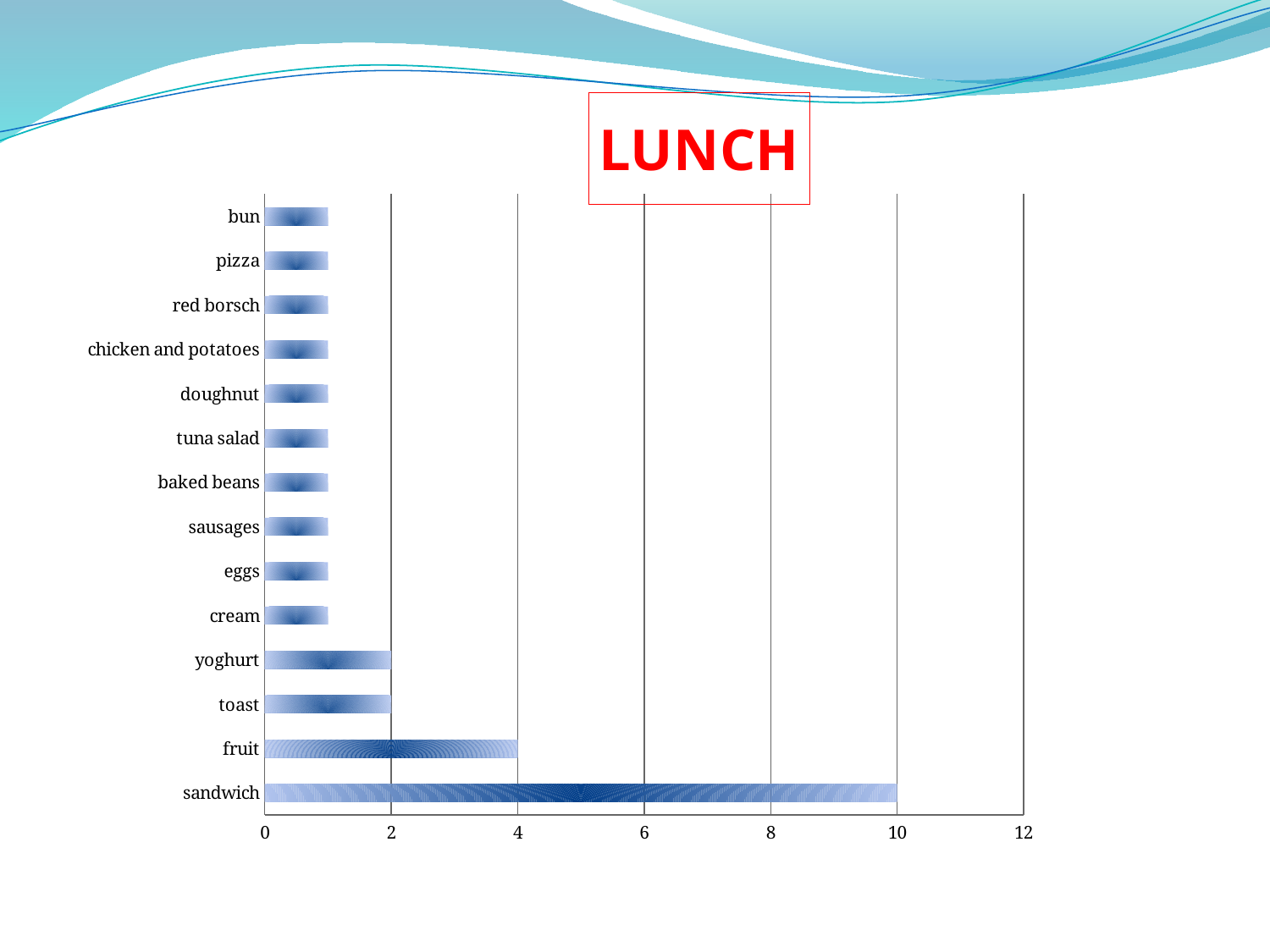
What kind of chart is shown on the slide? bar chart Is the value for bun greater or less than 2? less Which category has the highest value? sandwich What is the value for yoghurt? 2 What is the value for fruit? 4 How many categories are shown in the chart? 14 What is the value for sandwich? 10 What is the difference between the values for fruit and toast? 2 Which is larger, the value for fruit or the value for yoghurt? fruit What is the value for toast? 2 What is the title of the chart? LUNCH What is the difference between the values for sandwich and fruit? 6